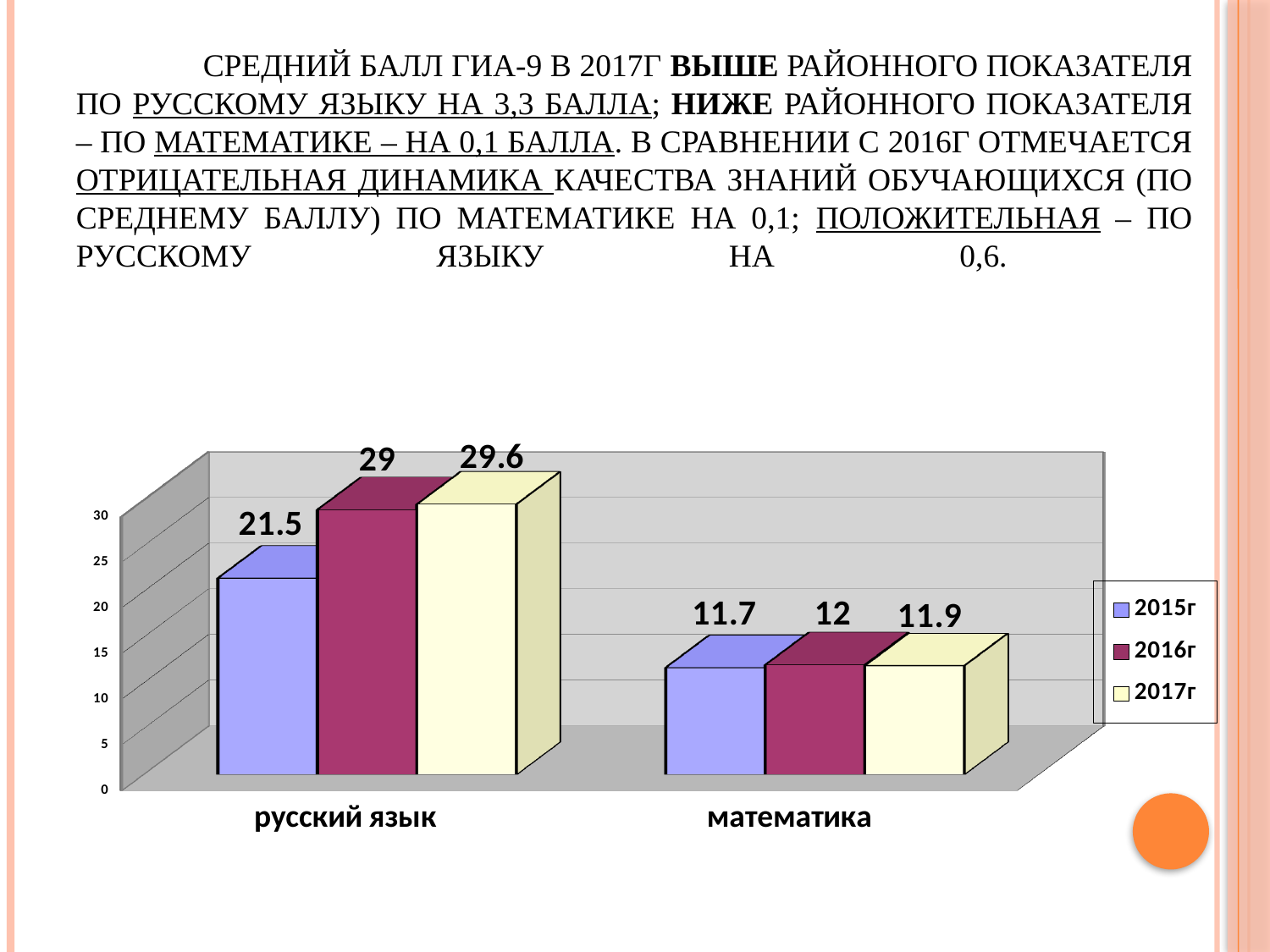
How many categories are shown on the x axis? 2 What is the value for русский язык in 2016г? 29 What is the difference between the 2016г and 2015г values for математика? 0.3 Which is larger: the 2016г value for русский язык or the 2016г value for математика? русский язык What is the value for математика in 2017г? 11.9 Which year has the lowest value for математика? 2015г How many series does the legend list? 3 What kind of chart is shown on the slide? bar chart What is the difference between the 2017г and 2015г values for русский язык? 8.1 What is the value for русский язык in 2015г? 21.5 Is the 2017г value for русский язык greater or less than 25? greater Which year has the highest value for русский язык? 2017г